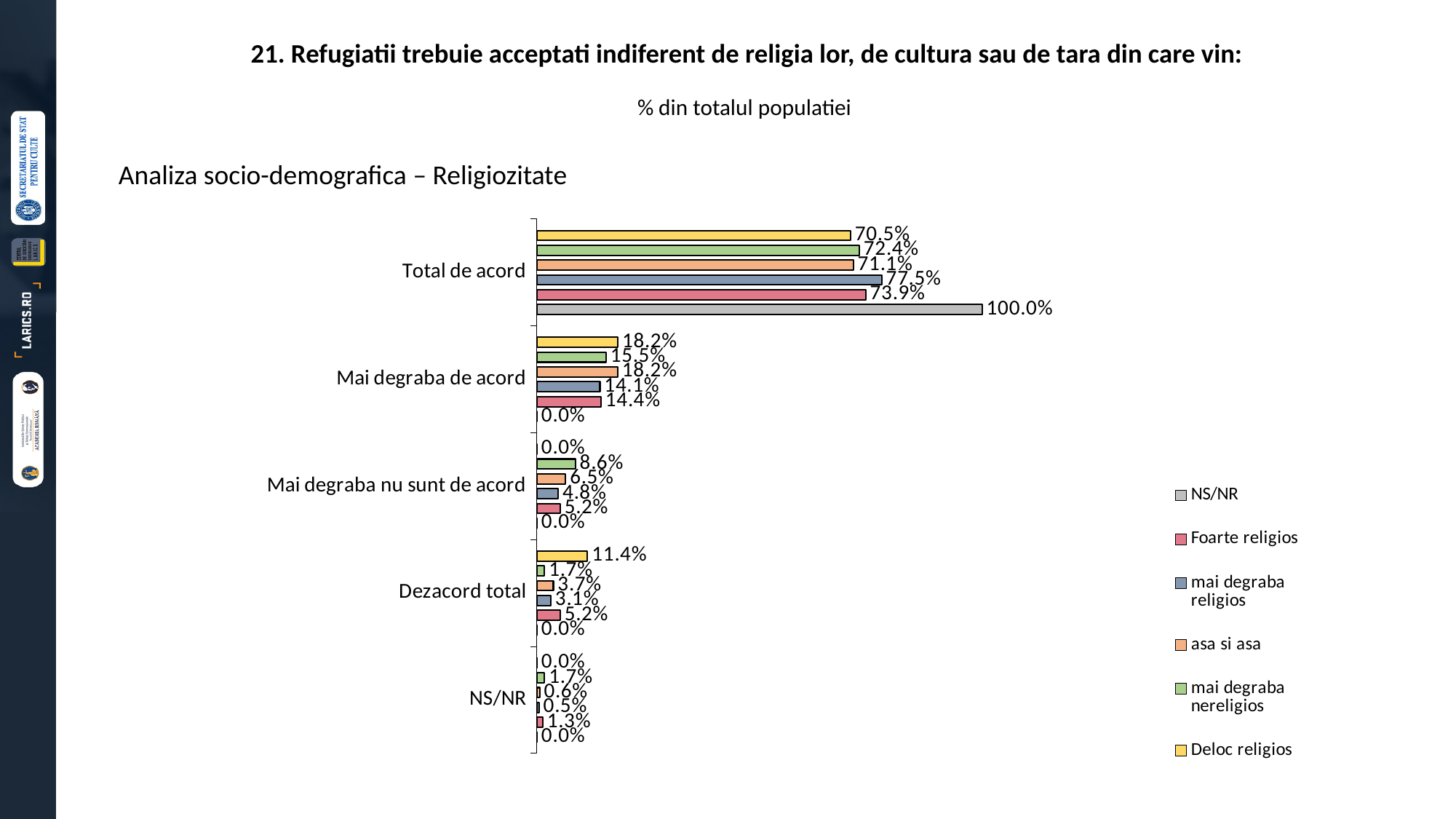
What is the value for 'Deloc religios' in the 'Dezacord total' category? 11.4% What is the value for 'mai degraba religios' in the 'Total de acord' category? 77.5% Which series has the lowest value in the 'Dezacord total' category, excluding the 0.0% NS/NR bar? mai degraba nereligios What is the value for 'Foarte religios' in the 'NS/NR' category? 1.3% In the 'Mai degraba de acord' category, which is larger: 'mai degraba nereligios' or 'mai degraba religios'? mai degraba nereligios How many response categories are shown on the vertical axis? 5 Which series has the highest value in the 'Total de acord' category? NS/NR What is the difference between 'mai degraba religios' and 'Deloc religios' in the 'Total de acord' category? 7.0% How many series does the legend list? 6 What is the subtitle shown below the chart title? % din totalul populatiei What type of chart is shown on the slide? bar chart What is the value for 'mai degraba nereligios' in the 'Mai degraba nu sunt de acord' category? 8.6%